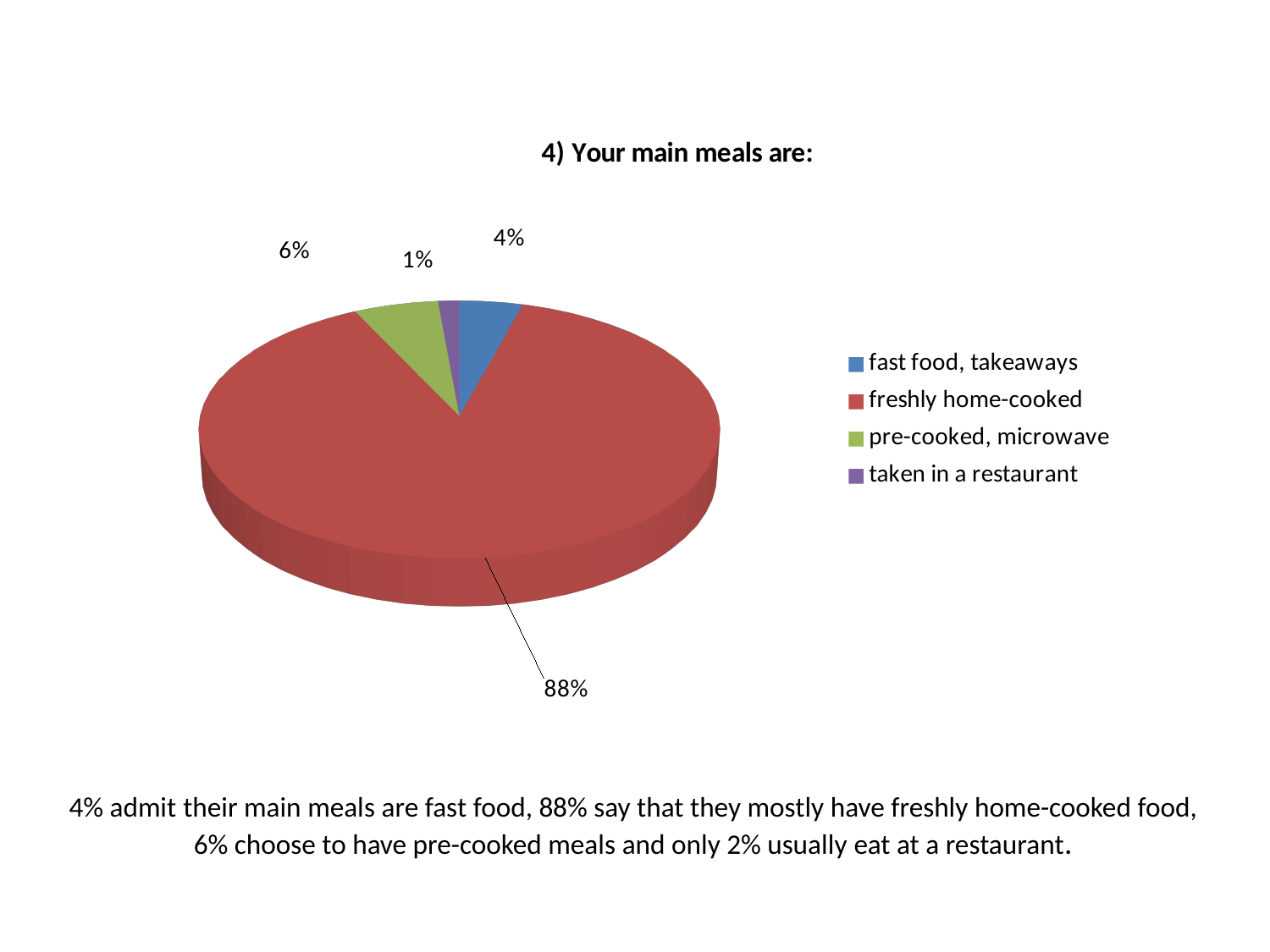
Which is larger, the slice for pre-cooked, microwave or the slice for fast food, takeaways? pre-cooked, microwave What kind of chart is shown on the slide? pie chart Which category has the largest slice of the pie? freshly home-cooked What percentage label is shown on the pie for taken in a restaurant? 1% What colour is the slice for freshly home-cooked? red What percentage of the pie is labelled for pre-cooked, microwave? 6% What is the difference between the freshly home-cooked share and the pre-cooked, microwave share? 82% What is the title of the chart? 4) Your main meals are: How many categories does the legend list? 4 What percentage of the pie is labelled for freshly home-cooked? 88% What percentage of the pie is labelled for fast food, takeaways? 4% Which category has the smallest slice of the pie? taken in a restaurant